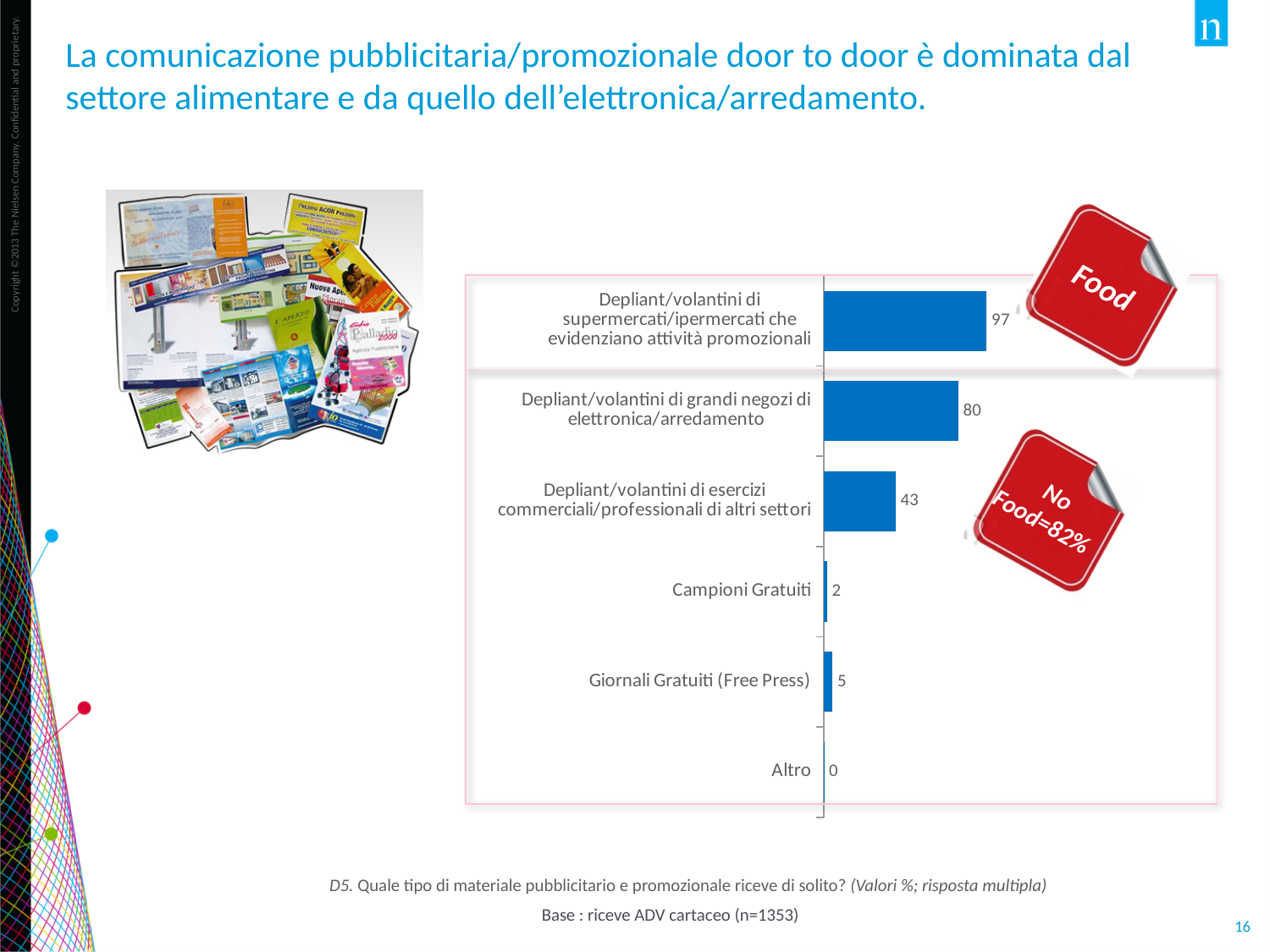
What is the value for "Campioni Gratuiti"? 2 What is the value for "Depliant/volantini di grandi negozi di elettronica/arredamento"? 80 What is the difference between the values for "Depliant/volantini di supermercati/ipermercati che evidenziano attività promozionali" and "Depliant/volantini di grandi negozi di elettronica/arredamento"? 17 What kind of chart is shown on the slide? Bar chart What is the base (n) stated below the chart? n=1353 What is the value for "Depliant/volantini di supermercati/ipermercati che evidenziano attività promozionali"? 97 Which category has the highest value? Depliant/volantini di supermercati/ipermercati che evidenziano attività promozionali Which category has the lowest value? Altro What is the difference between the values for "Depliant/volantini di grandi negozi di elettronica/arredamento" and "Depliant/volantini di esercizi commerciali/professionali di altri settori"? 37 Which is larger: the value for "Giornali Gratuiti (Free Press)" or the value for "Campioni Gratuiti"? Giornali Gratuiti (Free Press) How many categories are shown in the chart? 6 What is the value for "Giornali Gratuiti (Free Press)"? 5